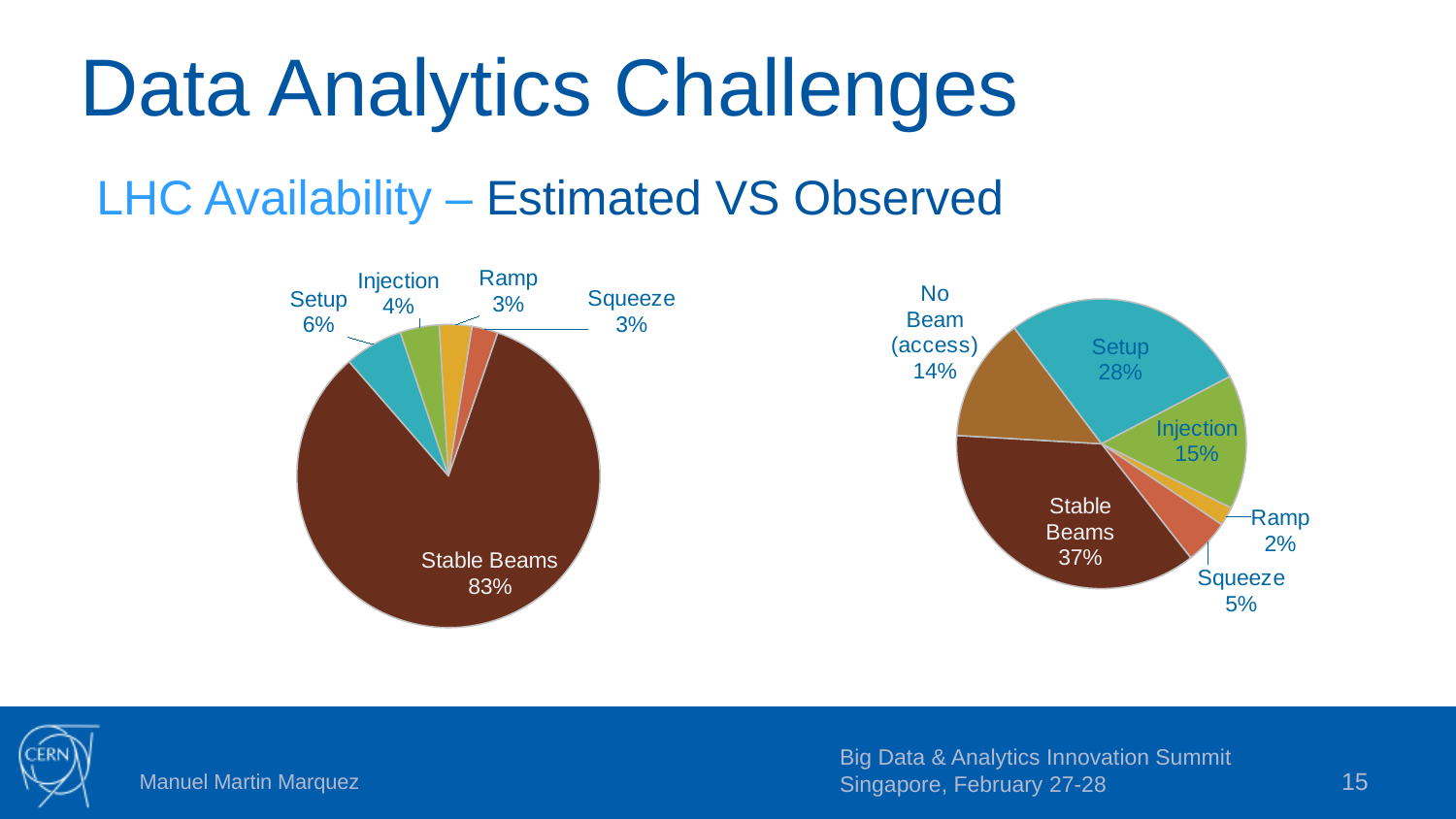
In the right pie chart, which category has the smallest slice? Ramp In the left pie chart, what share does Stable Beams have? 83% How many slices does the left pie chart have? 5 In the right pie chart, what share does No Beam (access) have? 14% What type of chart is shown on the left of the slide? Pie chart In the right pie chart, what share does Setup have? 28% In the left pie chart, which category has the largest slice? Stable Beams In the left pie chart, what is the value for Setup? 6% In the right pie chart, which category has the largest slice? Stable Beams In the right pie chart, which is larger: Injection or Squeeze? Injection How many slices does the right pie chart have? 6 What is the difference between the Stable Beams share in the left pie chart and the Stable Beams share in the right pie chart? 46%